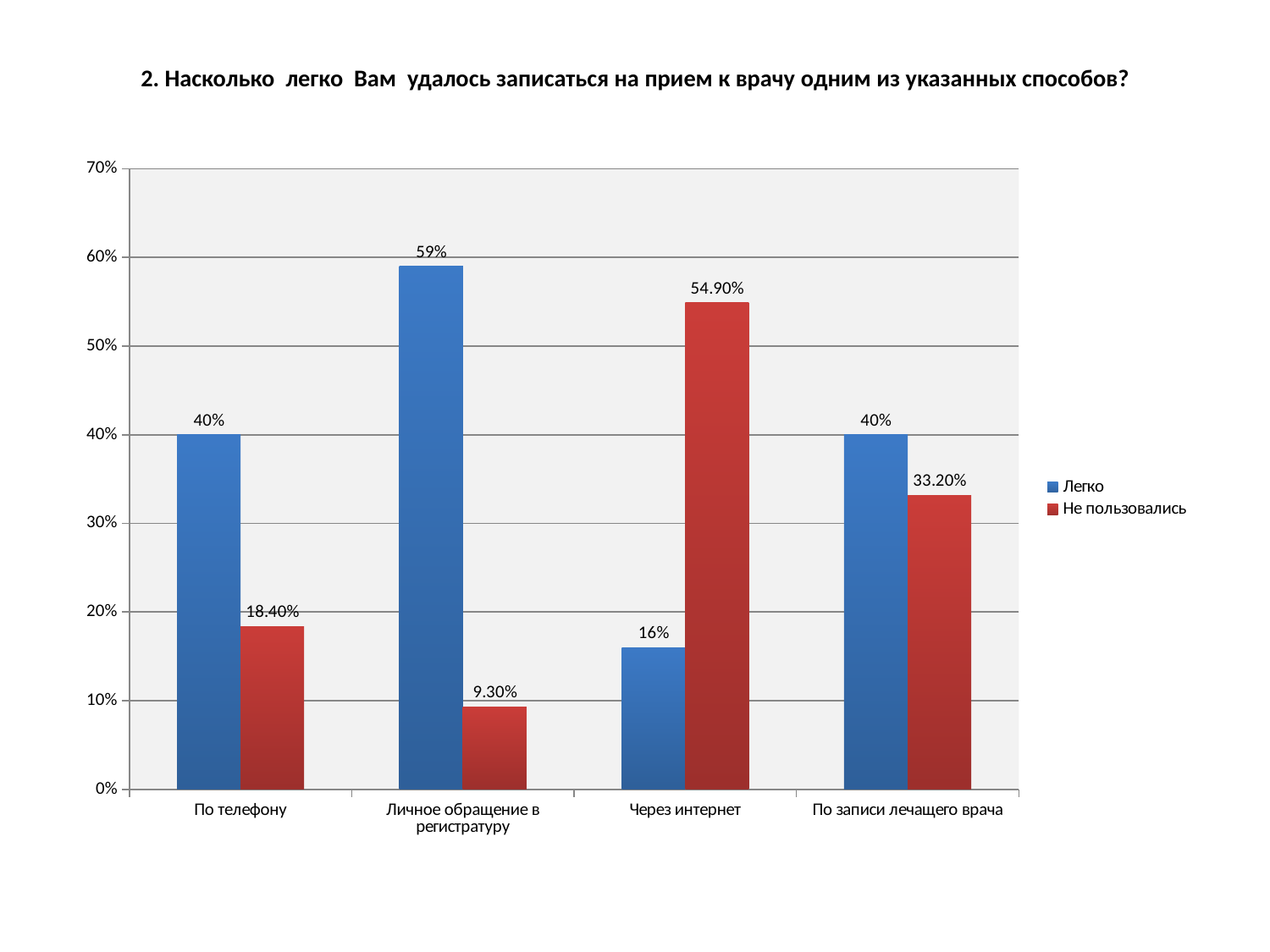
What is the value for "Не пользовались" for "Через интернет"? 54.90% What colour are the bars for the "Не пользовались" series? Red What is the value for "Не пользовались" for "По телефону"? 18.40% What kind of chart is shown on the slide? Bar chart What is the value for "Легко" for "Личное обращение в регистратуру"? 59% Which category has the highest value for "Легко"? Личное обращение в регистратуру Which category has the lowest value for "Не пользовались"? Личное обращение в регистратуру What is the value for "Легко" for "Через интернет"? 16% For "Через интернет", which series has the larger value, "Легко" or "Не пользовались"? Не пользовались How many series does the legend list? 2 How many categories are shown on the x axis? 4 What is the difference between the "Легко" and "Не пользовались" values for "По записи лечащего врача"? 6.80%